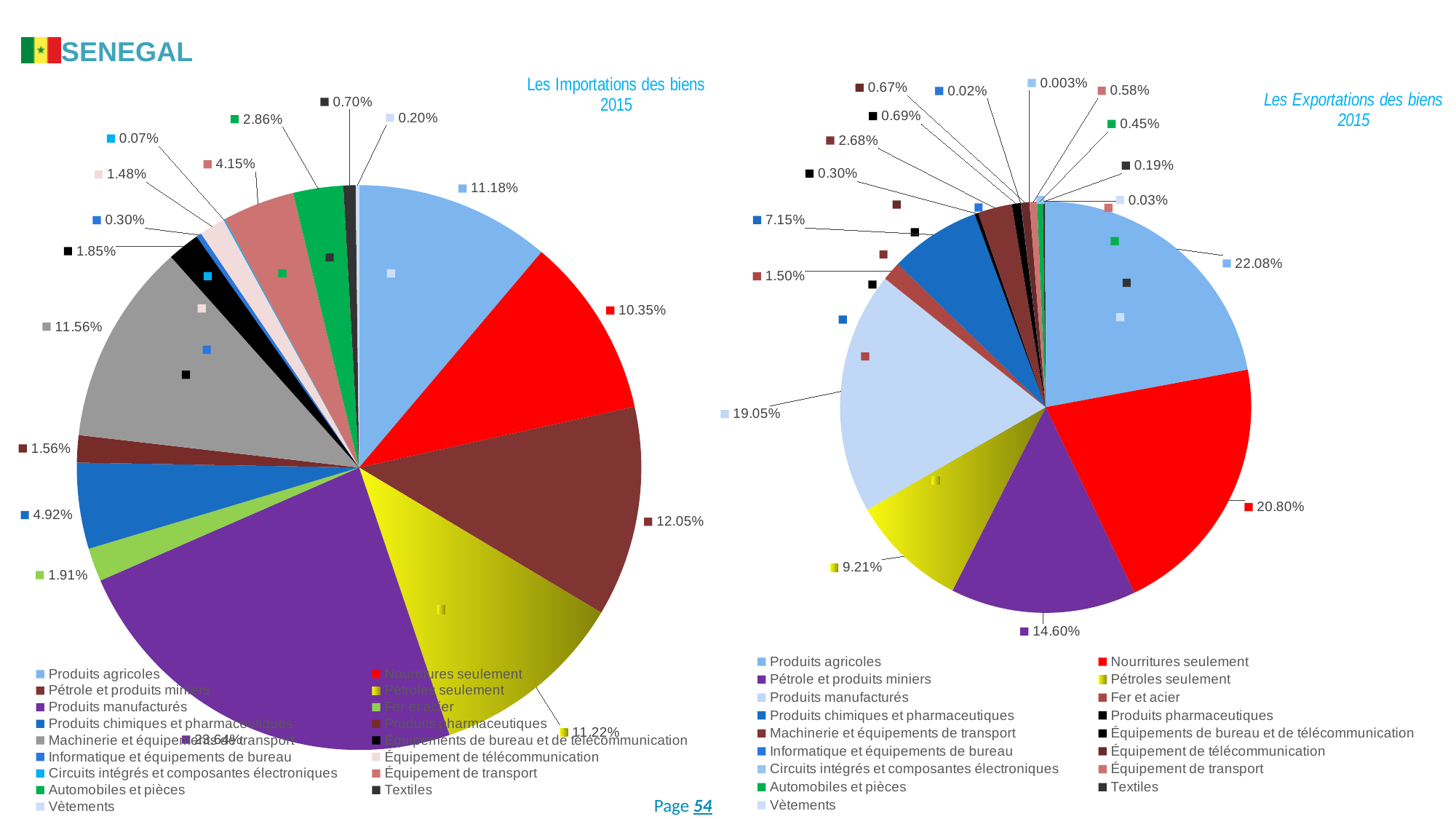
In the 'Les Exportations des biens 2015' chart, which category has the largest share? Produits agricoles How many categories does the legend of the 'Les Exportations des biens 2015' chart list? 17 What type of chart is used for 'Les Importations des biens 2015'? Pie chart In the 'Les Importations des biens 2015' chart, which is larger: Pétrole et produits miniers or Produits agricoles? Pétrole et produits miniers In the 'Les Exportations des biens 2015' chart, what is the share for Produits agricoles? 22.08% In the 'Les Exportations des biens 2015' chart, what is the share for Produits manufacturés? 19.05% In the 'Les Exportations des biens 2015' chart, what is the difference between the shares of Produits agricoles and Nourritures seulement? 1.28% In the 'Les Importations des biens 2015' chart, what is the share for Machinerie et équipements de transport? 11.56% In the 'Les Importations des biens 2015' chart, what is the share for Nourritures seulement? 10.35% In the 'Les Importations des biens 2015' chart, which category has the largest slice? Produits manufacturés In the 'Les Exportations des biens 2015' chart, what is the share for Nourritures seulement? 20.80% In the 'Les Exportations des biens 2015' chart, what is the share for Pétroles seulement? 9.21%